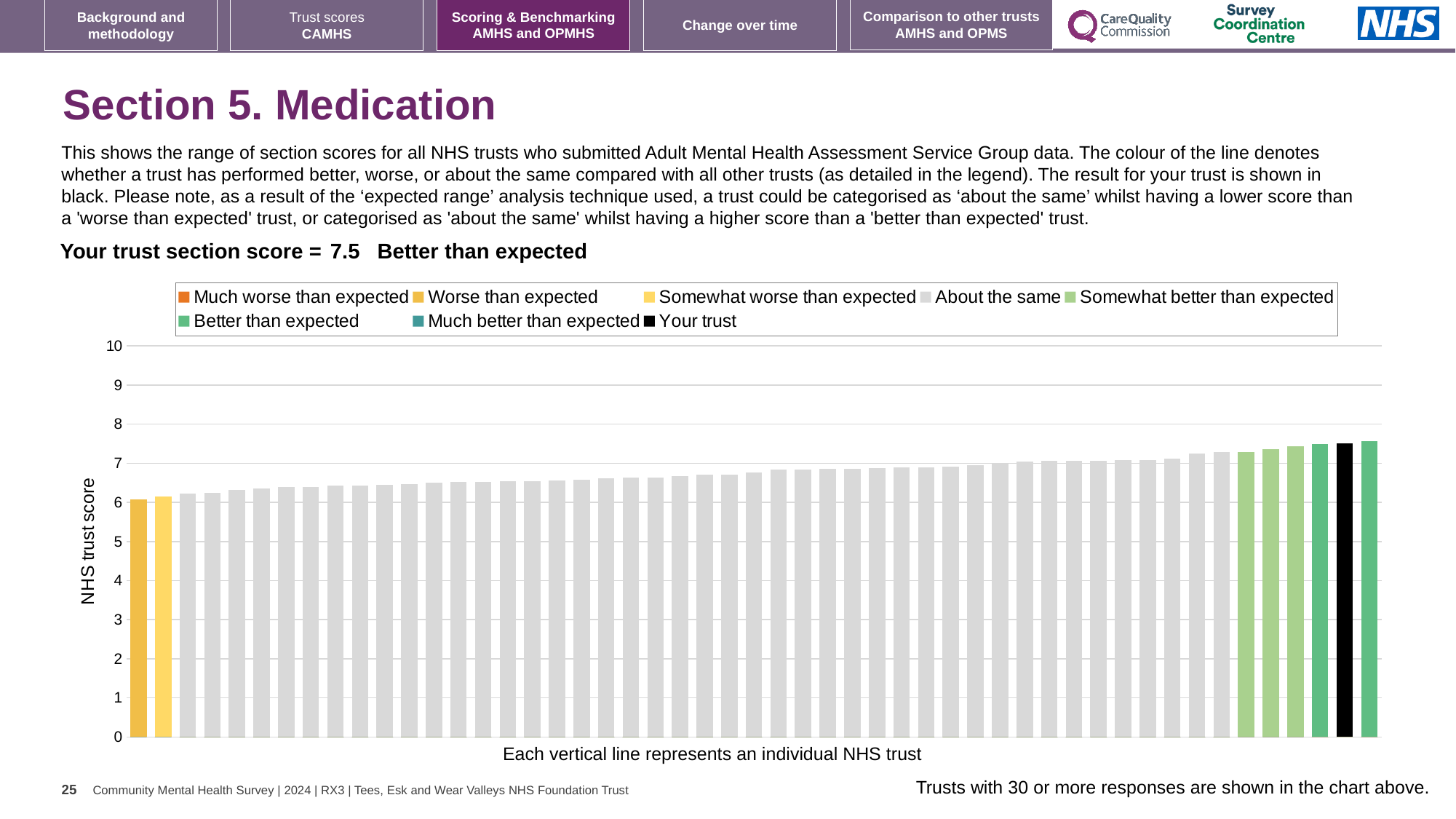
Is the value for your trust (the black bar) greater or less than 7? greater How many entries does the chart legend list? 8 Do the bar values rise or fall from left to right along the x axis? Rise What is the section score for your trust shown on the slide? 7.5 What is the title of the vertical axis? NHS trust score Is the value of the rightmost bar greater or less than 8? less What kind of chart is shown on the slide? Bar chart Is the value of the leftmost bar greater or less than 7? less Which legend category does the tallest bar belong to? Better than expected Which is larger: the value for your trust (black bar) or the value of the leftmost bar? Your trust How many black bars are in the chart? 1 What colour is used for the 'Your trust' bar according to the legend? Black